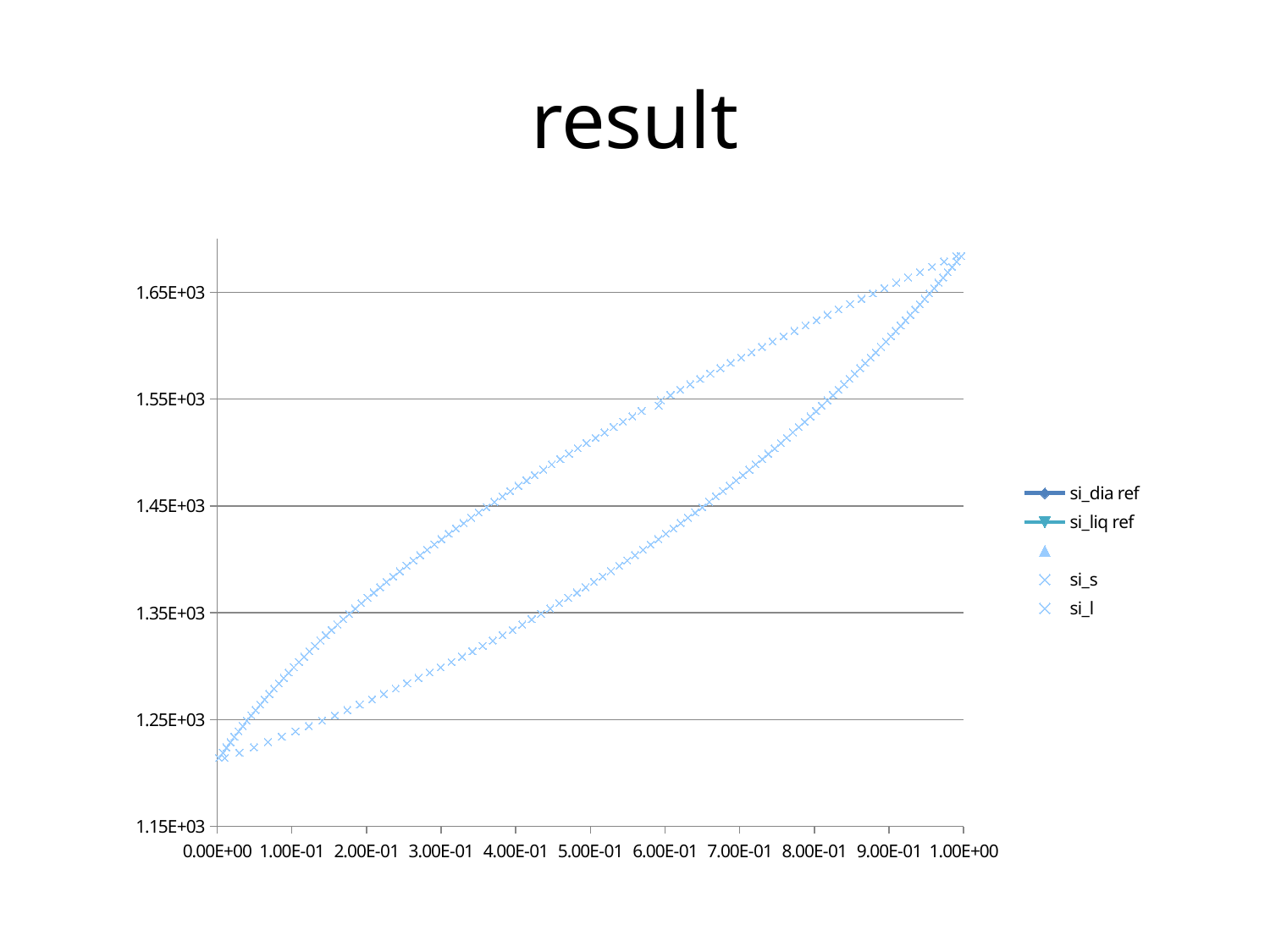
What is the highest tick label shown on the x axis? 1.00E+00 What is the lowest tick label shown on the y axis? 1.15E+03 How many tick labels are shown on the x axis? 11 At x = 0.00E+00, is the plotted value greater or less than 1.25E+03? less What kind of chart is shown on the slide? scatter chart What is the title of the chart? result Do the plotted values rise or fall as x increases from 0.00E+00 to 1.00E+00? rise At x = 1.00E+00, is the plotted value greater or less than 1.65E+03? greater How many legend entries have a readable name? 4 At x = 5.00E-01, is the value of the upper curve greater or less than 1.45E+03? greater How many entries does the chart legend list? 5